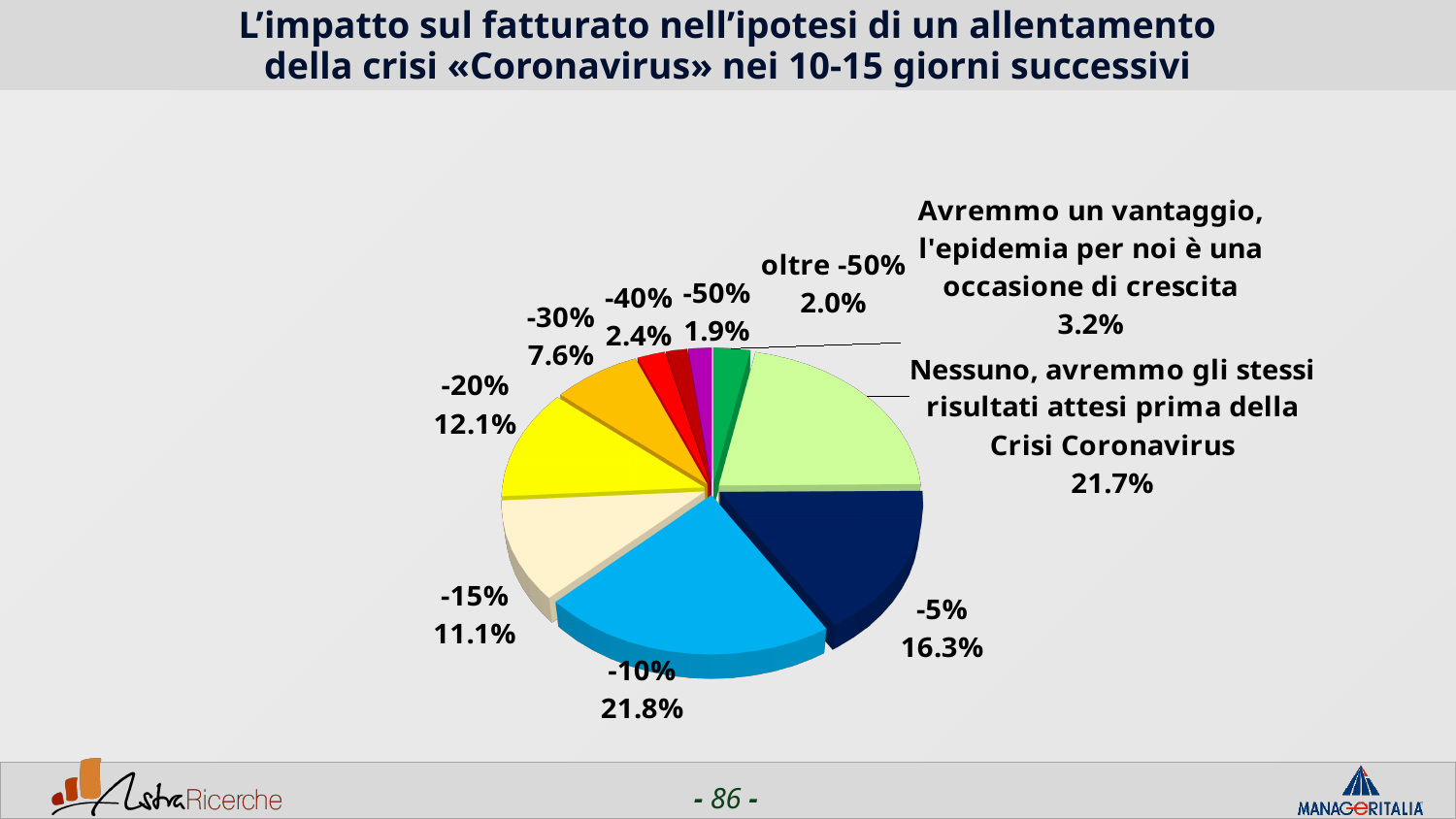
What share of the pie corresponds to 'Nessuno, avremmo gli stessi risultati attesi prima della Crisi Coronavirus'? 21.7% What is the value for the 'oltre -50%' slice? 2.0% What is the value for the slice labelled -5%? 16.3% How many slices does the pie chart have? 10 Which is larger, the slice for -30% or the slice for -40%? -30% What is the value for the -20% slice? 12.1% What is the difference in percentage points between the -10% slice and the -5% slice? 5.5 What is the title of the chart on the slide? L'impatto sul fatturato nell'ipotesi di un allentamento della crisi «Coronavirus» nei 10-15 giorni successivi What is the value for 'Avremmo un vantaggio, l'epidemia per noi è una occasione di crescita'? 3.2% Which is larger, the slice for -5% or the slice for -15%? -5% What kind of chart is shown on the slide? pie chart What percentage of respondents expect a -10% impact on revenue? 21.8%